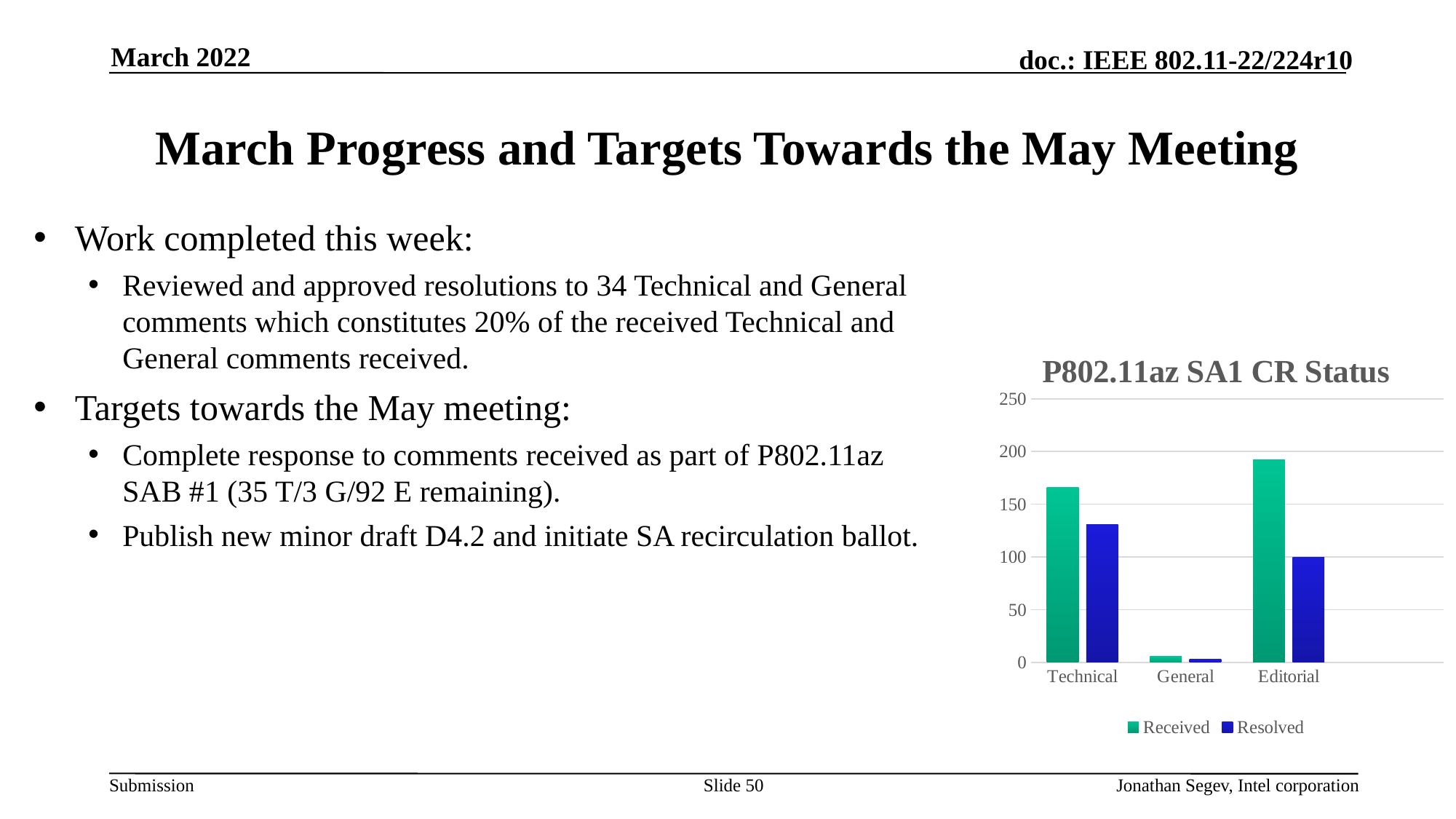
Is the Received value for Technical greater or less than 150? greater Which category has the highest Received value in the P802.11az SA1 CR Status chart? Editorial How many series does the legend of the P802.11az SA1 CR Status chart list? 2 Is the Received value for Editorial greater or less than 200? less Which category has the highest Resolved value in the P802.11az SA1 CR Status chart? Technical How many categories are shown on the x axis of the P802.11az SA1 CR Status chart? 3 Is the Received value for General greater or less than 50? less What is the title of the chart on the slide? P802.11az SA1 CR Status Which is larger for Editorial: the Received value or the Resolved value? Received Which category has the lowest Received value in the P802.11az SA1 CR Status chart? General What kind of chart is the P802.11az SA1 CR Status chart? bar chart